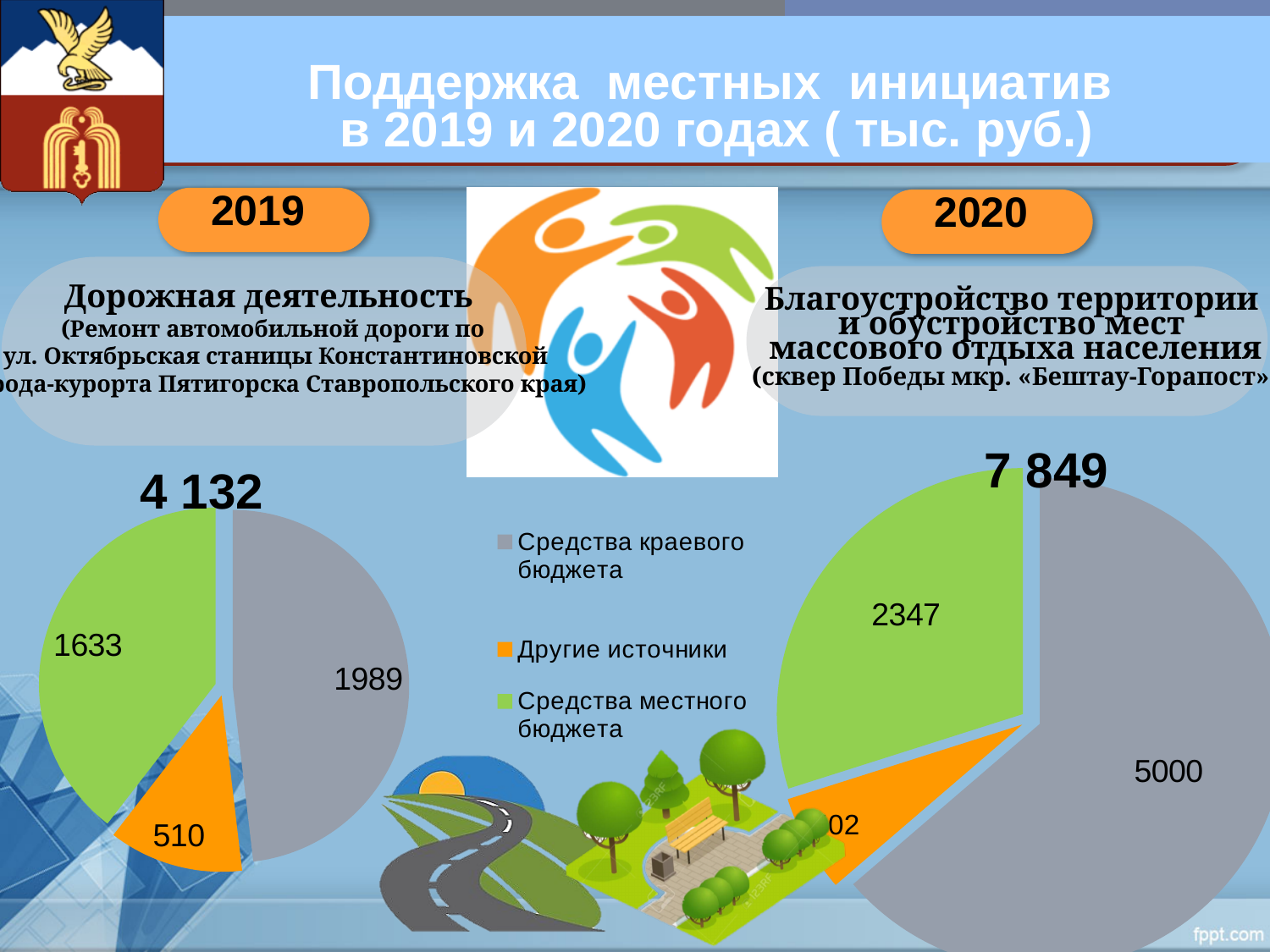
In the 2019 pie chart, what is the difference between Средства краевого бюджета and Средства местного бюджета? 356 In the 2019 pie chart, what is the value for Другие источники? 510 Which is larger: Средства краевого бюджета in 2020 or Средства краевого бюджета in 2019? 2020 How many categories does the legend list for the pie charts? 3 In the 2020 pie chart, what is the value for Средства краевого бюджета? 5000 In the 2019 pie chart, what is the value for Средства местного бюджета? 1633 In the 2020 pie chart, which source has the largest value? Средства краевого бюджета In the 2019 pie chart, what is the value for Средства краевого бюджета? 1989 What kind of chart is used for the 2019 data on the left? Pie chart What total is shown above the 2020 pie chart? 7 849 In the 2019 pie chart, which source has the smallest value? Другие источники In the 2020 pie chart, what is the value for Средства местного бюджета? 2347